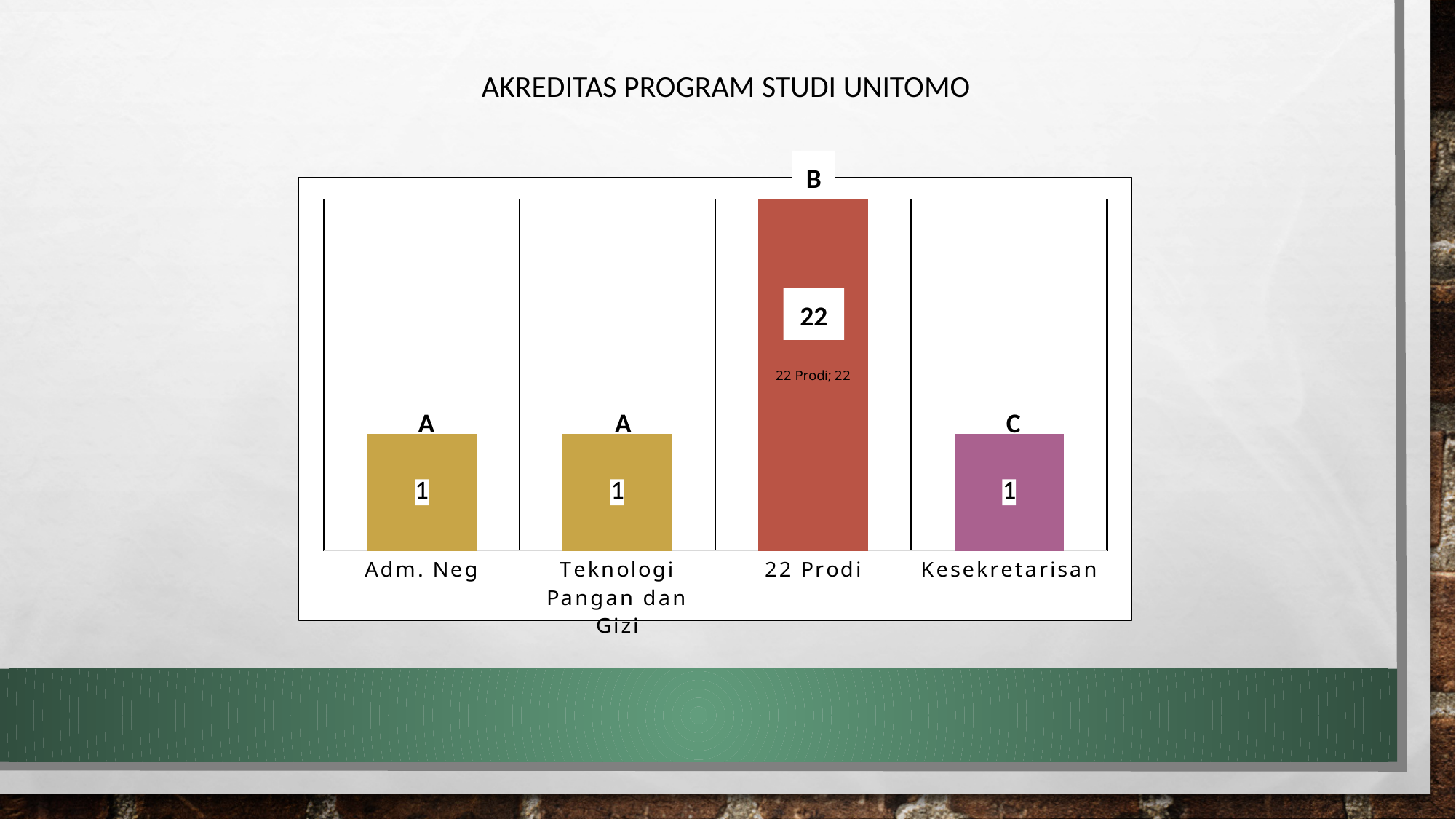
What type of chart is shown on the slide? bar chart What is the value for Kesekretarisan? 1 How many categories are shown on the x axis of the chart? 4 What is the value for Teknologi Pangan dan Gizi? 1 What is the difference between the values for 22 Prodi and Kesekretarisan? 21 What accreditation letter is shown above the bar for Kesekretarisan? C Which category has the highest value? 22 Prodi What is the value for 22 Prodi? 22 What is the total of the values for all four categories? 25 What is the value for Adm. Neg? 1 Which is larger, the value for 22 Prodi or the value for Adm. Neg? 22 Prodi What is the title of the chart? AKREDITAS PROGRAM STUDI UNITOMO